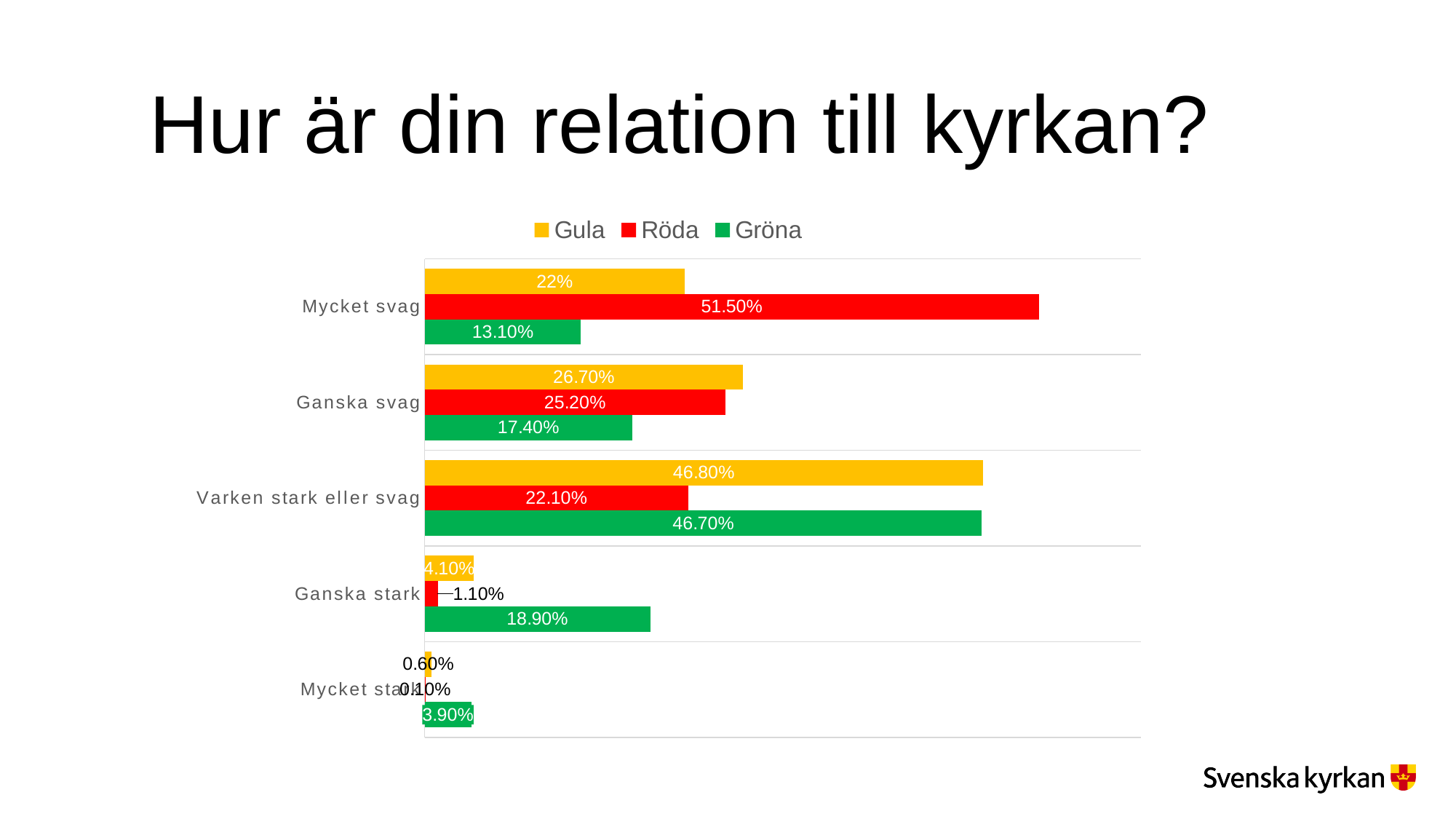
How many categories are shown on the chart? 5 What kind of chart is shown on the slide? Bar chart What is the value for Röda in the Mycket svag category? 51.50% In which category does Röda have its highest value? Mycket svag What colour represents the Röda series in the chart? Red How many series does the legend list? 3 In the Mycket svag category, which series has the larger value, Gula or Gröna? Gula What is the value for Gröna in the Mycket stark category? 3.90% In which category does Gröna have its lowest value? Mycket stark What is the difference between the Gula and Gröna values in the Ganska svag category? 9.30% What is the value for Gröna in the Ganska stark category? 18.90% What is the value for Gula in the Varken stark eller svag category? 46.80%